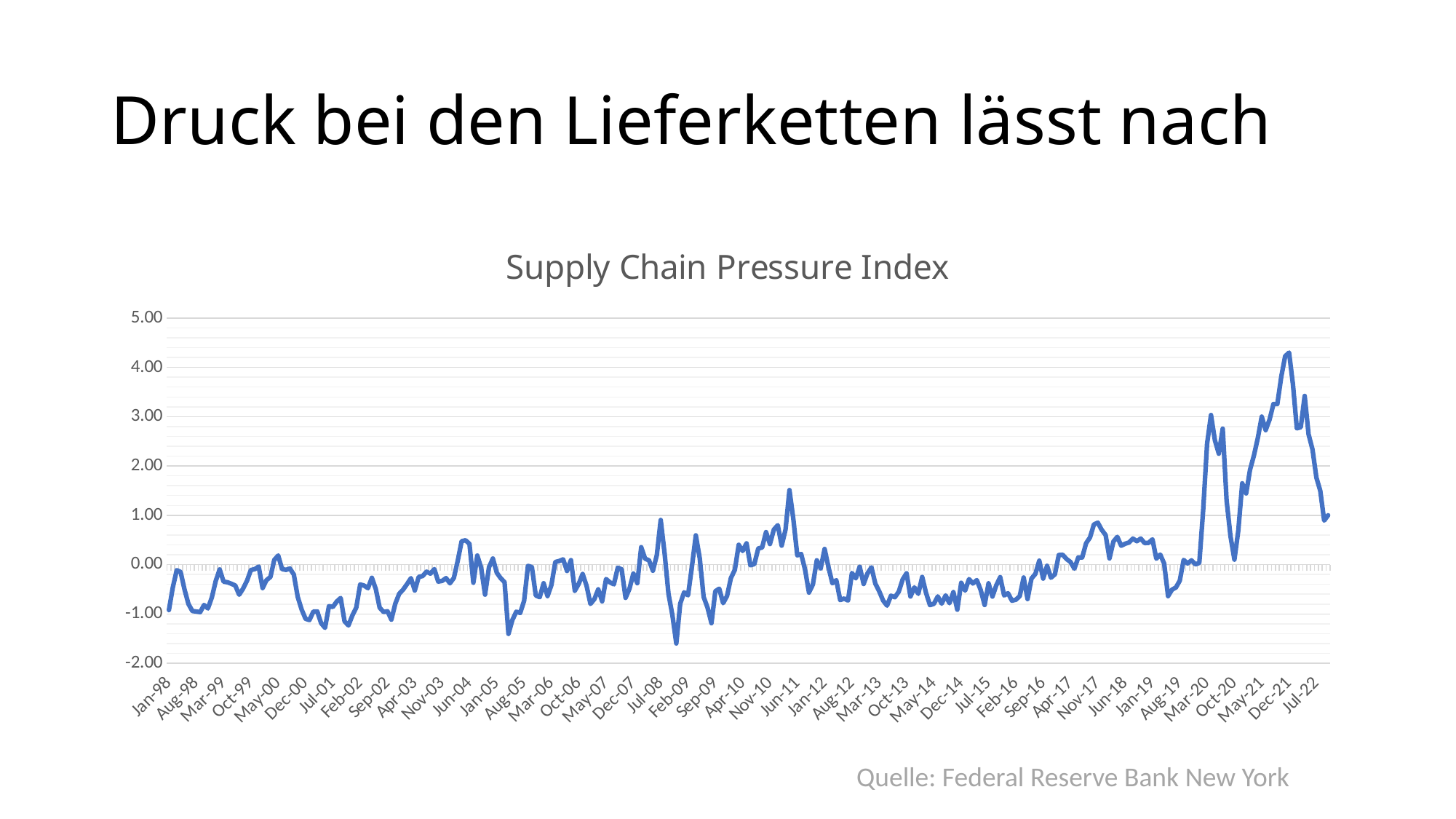
Does the index rise or fall between Aug-19 and Mar-20? rise Around which x-axis label does the index reach its lowest value? Feb-09 Does the index rise or fall between Dec-21 and Jul-22? fall Is the value of the index at Jul-22 greater or less than 2.00? less What is the title of the chart? Supply Chain Pressure Index Around which x-axis label does the index reach its highest value? Dec-21 What kind of chart is shown on the slide? line chart What source is cited below the chart? Federal Reserve Bank New York Is the index higher at Dec-21 or at Jun-11? Dec-21 Is the value of the index at Jan-98 greater or less than 0.00? less Is the peak value of the index around Dec-21 greater or less than 4.00? greater